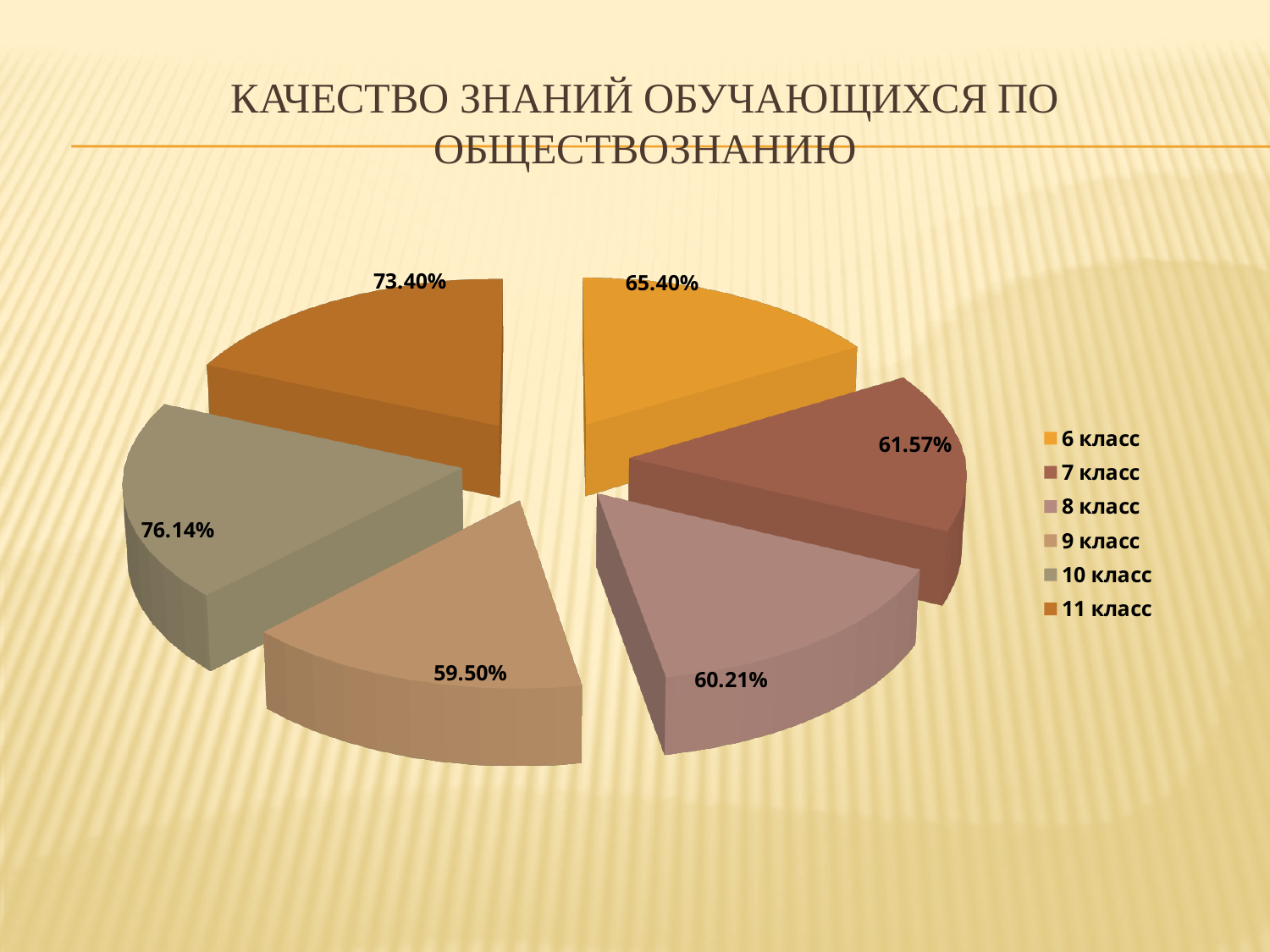
What is the value shown for 6 класс? 65.40% Which class has the highest value in the chart? 10 класс What is the value shown for 10 класс? 76.14% Which class has the lowest value in the chart? 9 класс Which is larger, the value for 7 класс or the value for 11 класс? 11 класс What is the difference between the values for 11 класс and 6 класс? 8.00% What is the difference between the values for 10 класс and 9 класс? 16.64% What is the title of the slide? Качество знаний обучающихся по обществознанию How many classes are shown in the chart? 6 What type of chart is shown on the slide? Pie chart What is the value shown for 9 класс? 59.50% What is the value shown for 8 класс? 60.21%